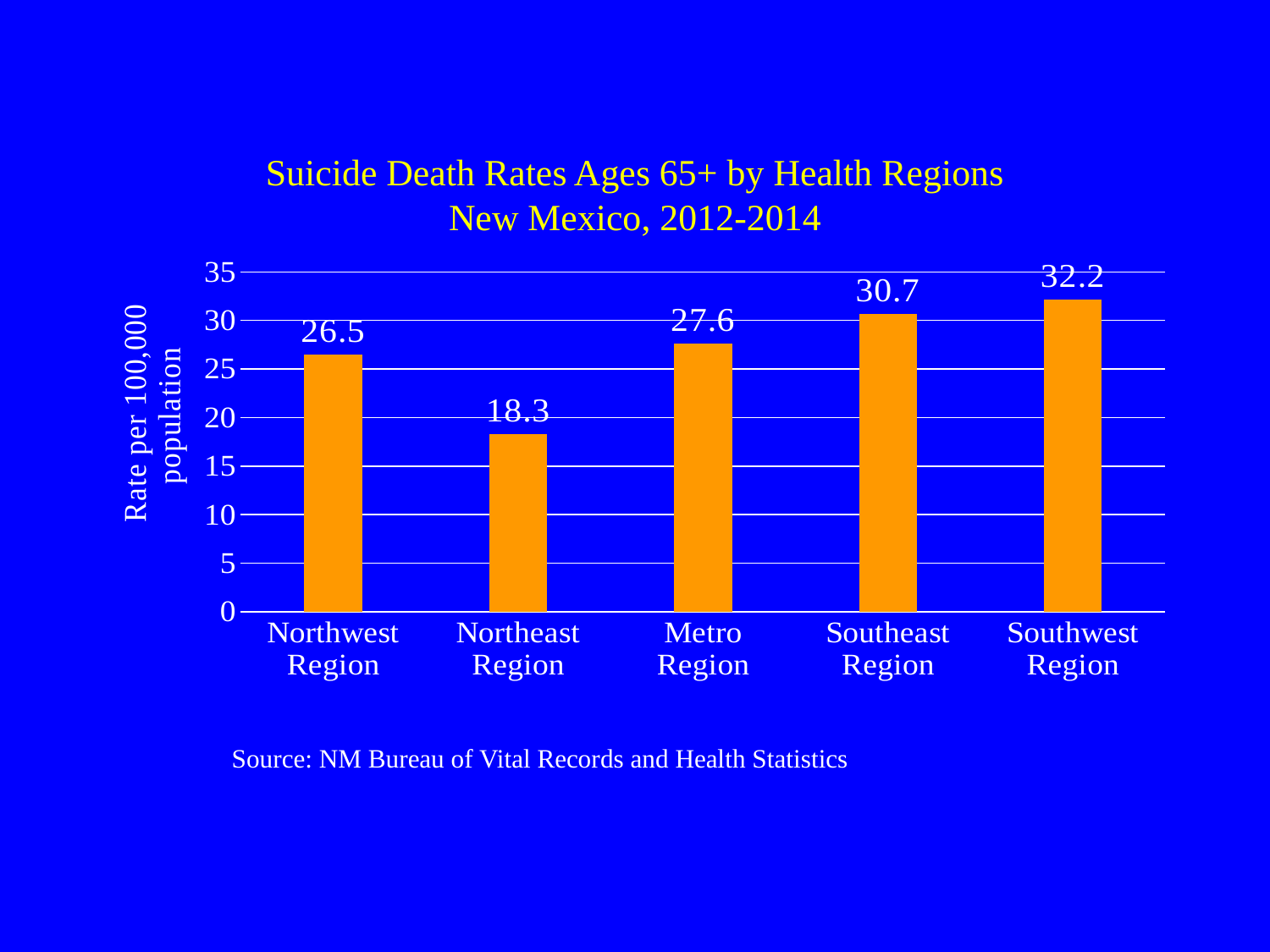
What kind of chart is shown on the slide? Bar chart What is the suicide death rate for the Northeast Region? 18.3 What is the suicide death rate for the Metro Region? 27.6 Which health region has the highest suicide death rate? Southwest Region Which health region has the lowest suicide death rate? Northeast Region How many health regions are shown in the chart? 5 What is the label on the vertical axis of the chart? Rate per 100,000 population What is the suicide death rate for the Southeast Region? 30.7 Which has a higher suicide death rate, the Southeast Region or the Northwest Region? Southeast Region What is the suicide death rate for the Northwest Region? 26.5 What is the difference between the suicide death rates of the Southwest Region and the Northeast Region? 13.9 Is the value for the Northeast Region greater or less than 20? less